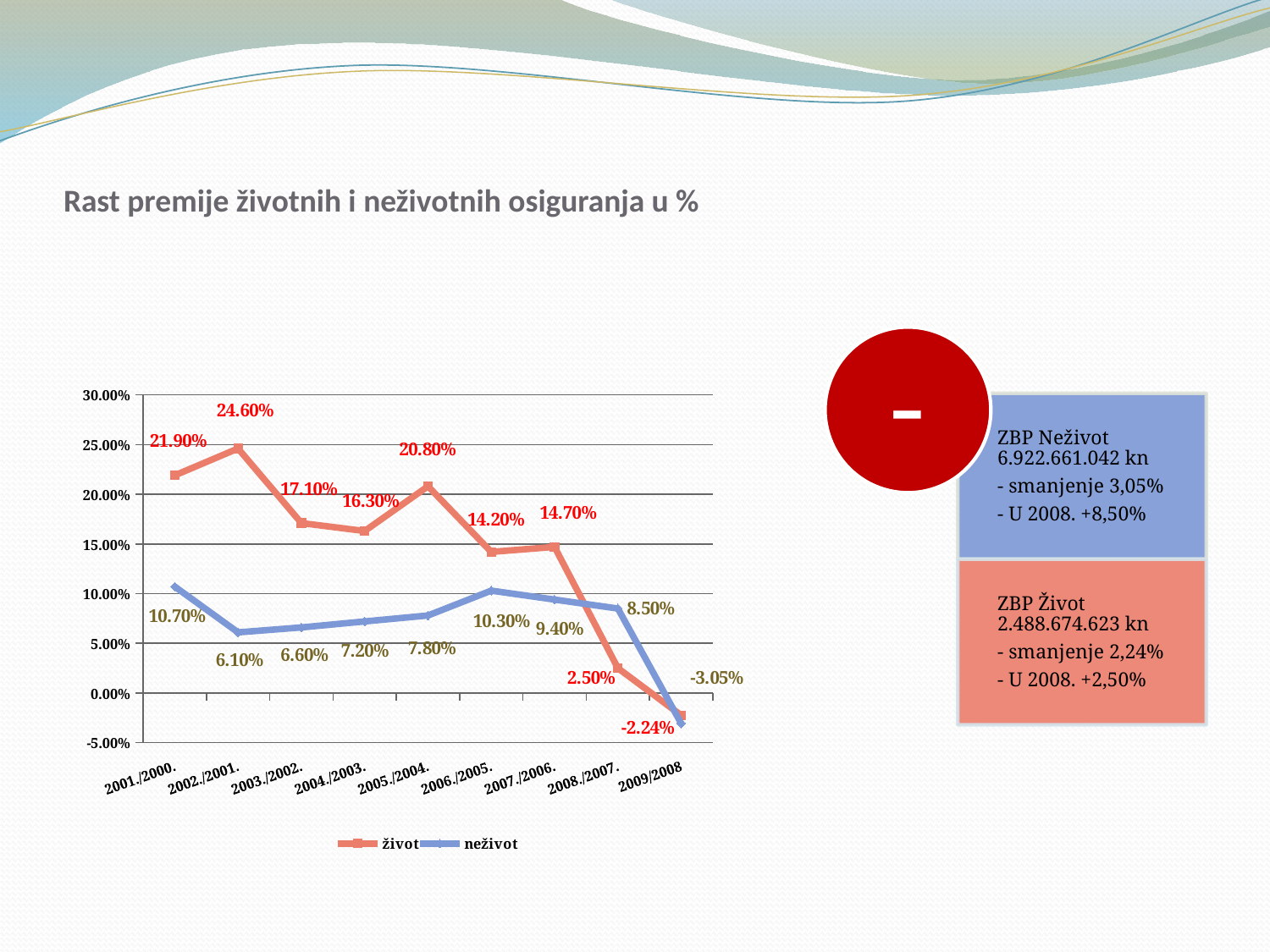
What is the difference between život and neživot in 2005./2004.? 13.00% Which series has the higher value in 2008./2007., život or neživot? neživot What type of chart is shown on the slide? line chart How many series does the legend list? 2 Does the život series generally rise or fall from 2001./2000. to 2009/2008? fall What is the value for život in 2009/2008? -2.24% How many periods are shown on the x axis? 9 In which period is the život series at its highest? 2002./2001. What is the value for život in 2002./2001.? 24.60% What is the title of the chart? Rast premije životnih i neživotnih osiguranja u % What is the value for neživot in 2006./2005.? 10.30% In which period is the neživot series at its lowest? 2009/2008